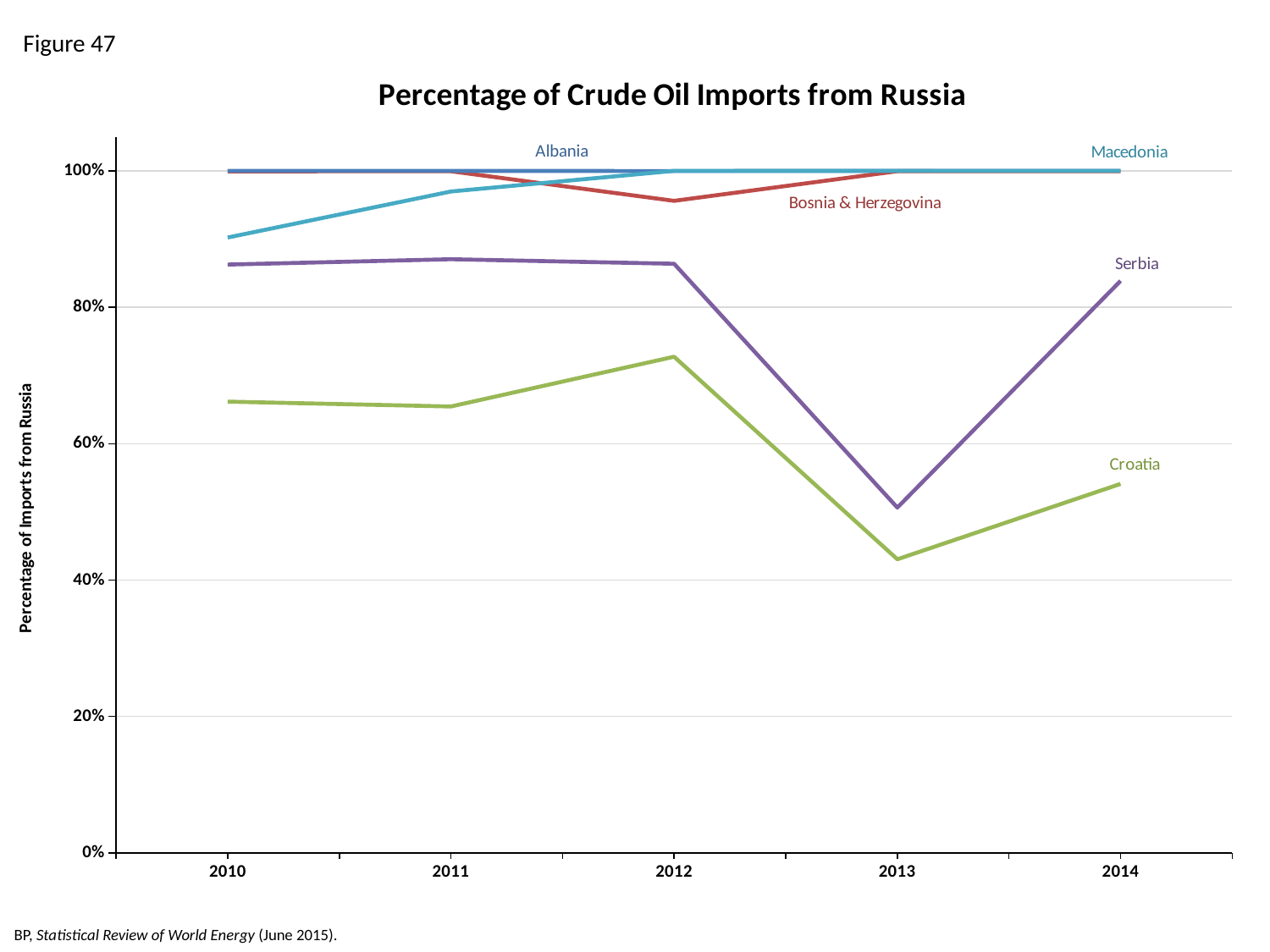
How many years are shown on the x axis? 5 Is the value for Croatia in 2012 greater or less than 60%? greater What kind of chart is shown on the slide? line chart Is the value for Serbia in 2014 greater or less than 80%? greater How many countries (series) are plotted on the chart? 5 What is the title of the chart? Percentage of Crude Oil Imports from Russia Which country has the lowest value in 2013? Croatia Does the value for Serbia rise or fall from 2013 to 2014? rise Is the value for Croatia in 2013 greater or less than 60%? less Which is larger in 2012, the value for Serbia or the value for Croatia? Serbia